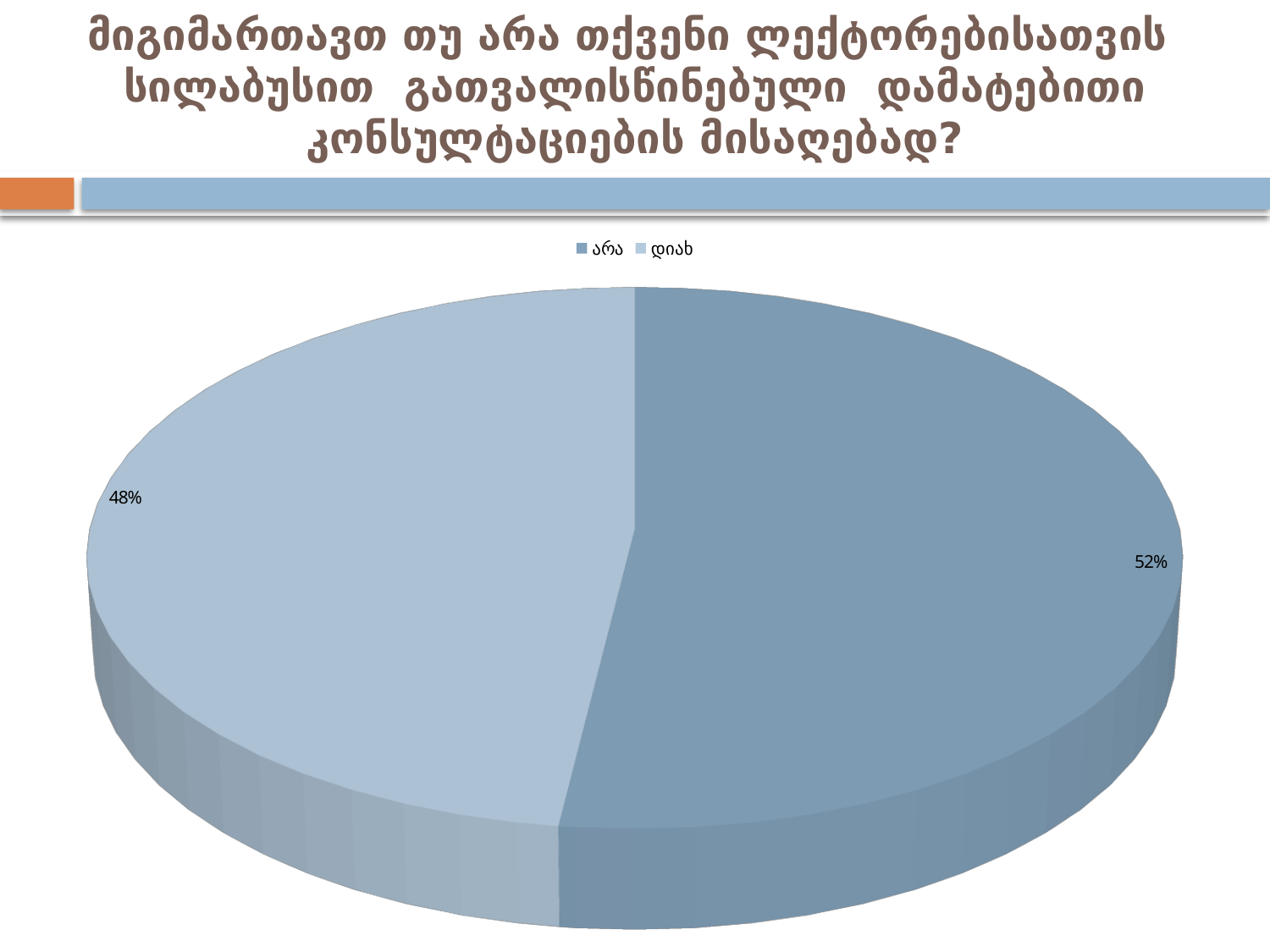
What is the difference in percentage points between the "არა" slice and the "დიახ" slice? 4 What percentage is shown for the slice labelled "დიახ"? 48% Which legend entry is shown in the darker blue colour? არა Which slice is the smallest in the pie chart? დიახ Which legend entry appears first (leftmost) in the legend? არა What share of the pie does the "დიახ" slice represent? 48% What percentage is shown for the slice labelled "არა"? 52% What kind of chart is shown on the slide? pie chart How many slices does the pie chart have? 2 Which is larger, the "არა" slice or the "დიახ" slice? არა How many entries does the legend list? 2 Which slice is the largest in the pie chart? არა